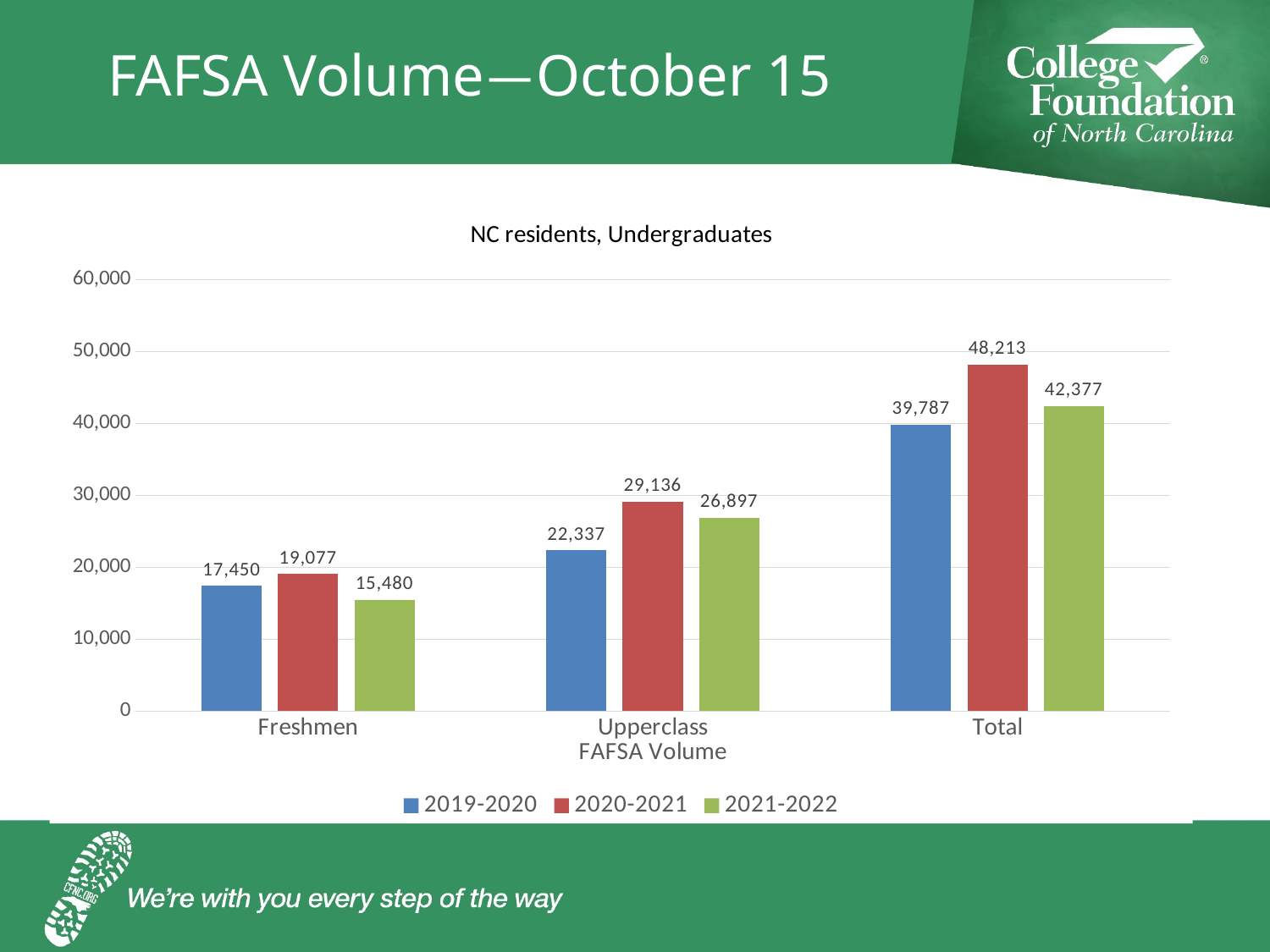
How many series does the legend list? 3 What is the Total FAFSA volume for 2020-2021? 48,213 How many categories are shown on the x axis? 3 What is the difference between the Total FAFSA volume in 2020-2021 and 2021-2022? 5,836 Which year has the highest Total FAFSA volume? 2020-2021 What kind of chart is shown on the slide? bar chart Which year has the lowest FAFSA volume for Freshmen? 2021-2022 Which is larger, the Upperclass FAFSA volume in 2019-2020 or in 2021-2022? 2021-2022 What is the FAFSA volume for Upperclass in 2021-2022? 26,897 What is the FAFSA volume for Freshmen in 2019-2020? 17,450 Is the Total FAFSA volume for 2019-2020 greater or less than 40,000? less What is the title of the chart? NC residents, Undergraduates